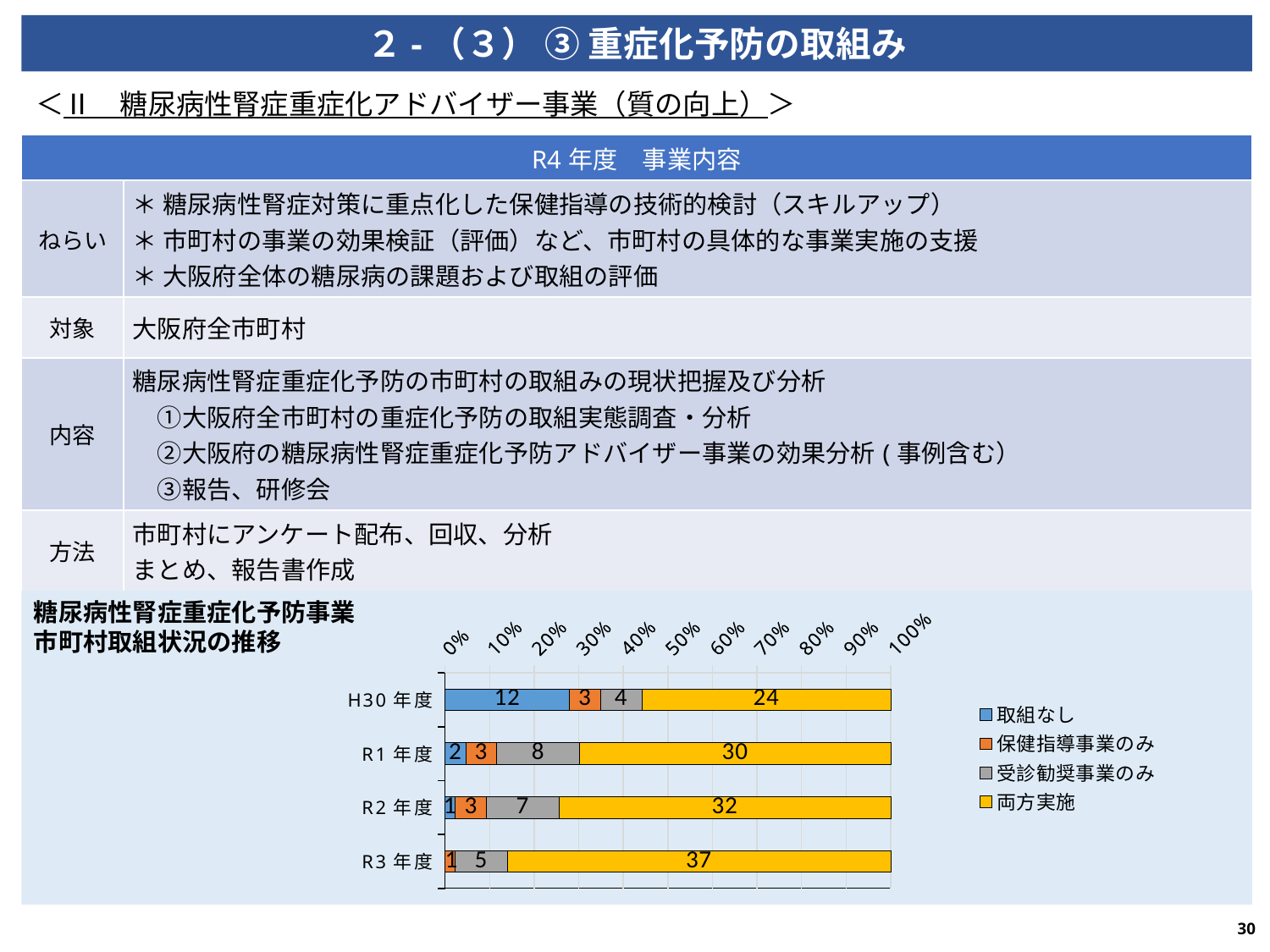
Which fiscal year has the highest value for 両方実施? R3年度 How many fiscal years (categories) are plotted in the chart? 4 What kind of chart is shown at the bottom of the slide? Stacked bar chart What is the value of 受診勧奨事業のみ for R1年度? 8 How many series does the legend of the chart list? 4 What is the total of all segments in the H30年度 bar? 43 What is the value of 両方実施 for H30年度? 24 Which is larger, the 取組なし value for H30年度 or for R1年度? H30年度 Does the value of 両方実施 rise or fall from H30年度 to R3年度? Rise What colour represents 両方実施 in the chart legend? Yellow What is the difference between the 両方実施 values for R3年度 and H30年度? 13 What is the value of 両方実施 for R3年度? 37